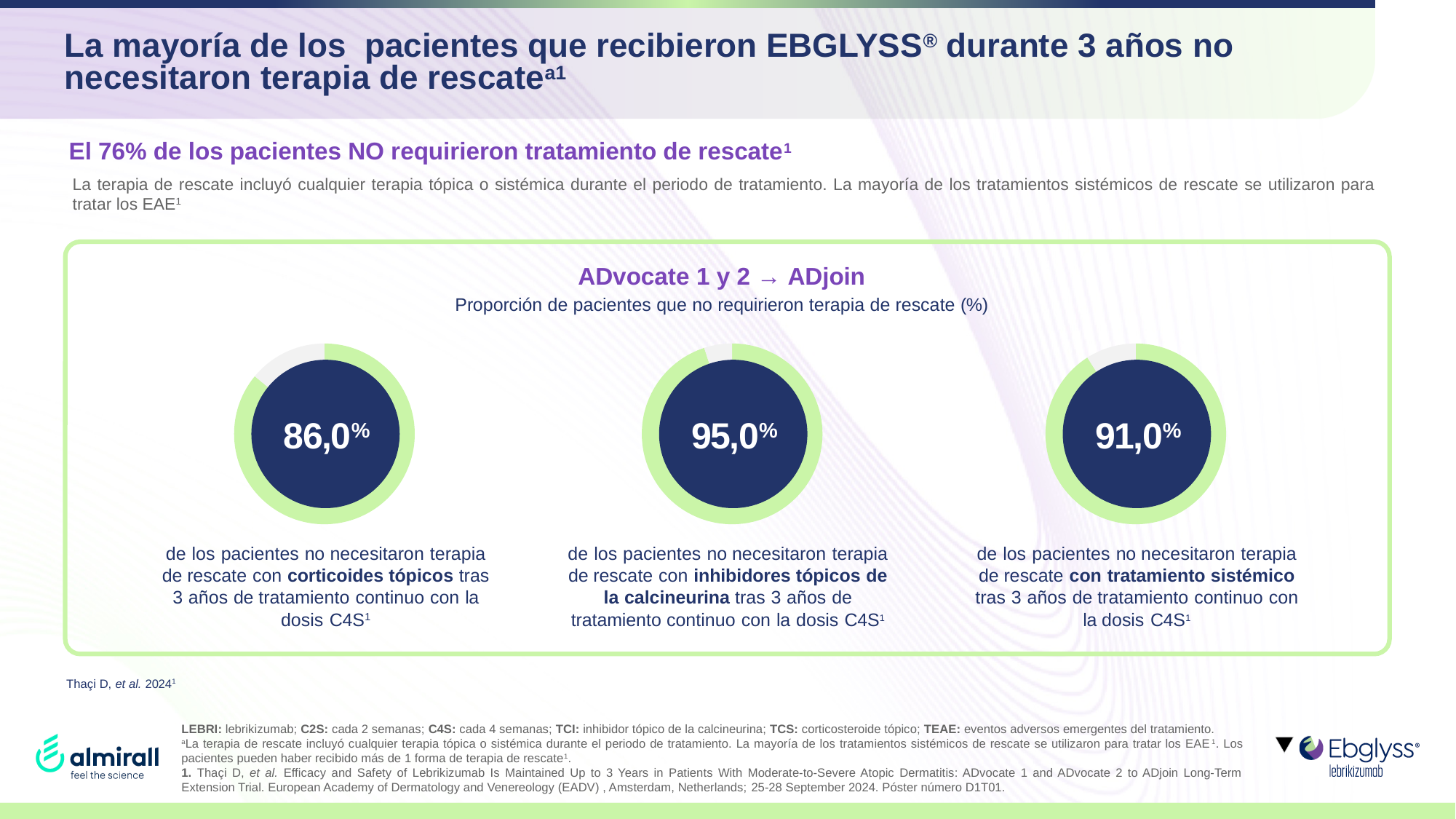
Which of the three rescue therapy categories shows the highest proportion of patients not needing it? inhibidores tópicos de la calcineurina What is the difference in percentage points between the value for topical calcineurin inhibitors and the value for topical corticosteroids? 9,0 What percentage of patients did not need rescue therapy with systemic treatment (tratamiento sistémico) after 3 years? 91,0% How many circular charts are shown in the green box on the slide? 3 What is the title shown above the three charts? ADvocate 1 y 2 → ADjoin Is the value for topical corticosteroids greater or less than 90%? less What percentage of patients did not need rescue therapy with topical corticosteroids (corticoides tópicos) after 3 years of continuous treatment with the C4S dose? 86,0% Which is larger: the proportion for systemic treatment or the proportion for topical corticosteroids? tratamiento sistémico What kind of chart is used to display the three percentages? donut chart What is the difference in percentage points between the value for systemic treatment and the value for topical corticosteroids? 5,0 Which of the three rescue therapy categories shows the lowest proportion of patients not needing it? corticoides tópicos What percentage of patients did not need rescue therapy with topical calcineurin inhibitors (inhibidores tópicos de la calcineurina) after 3 years? 95,0%